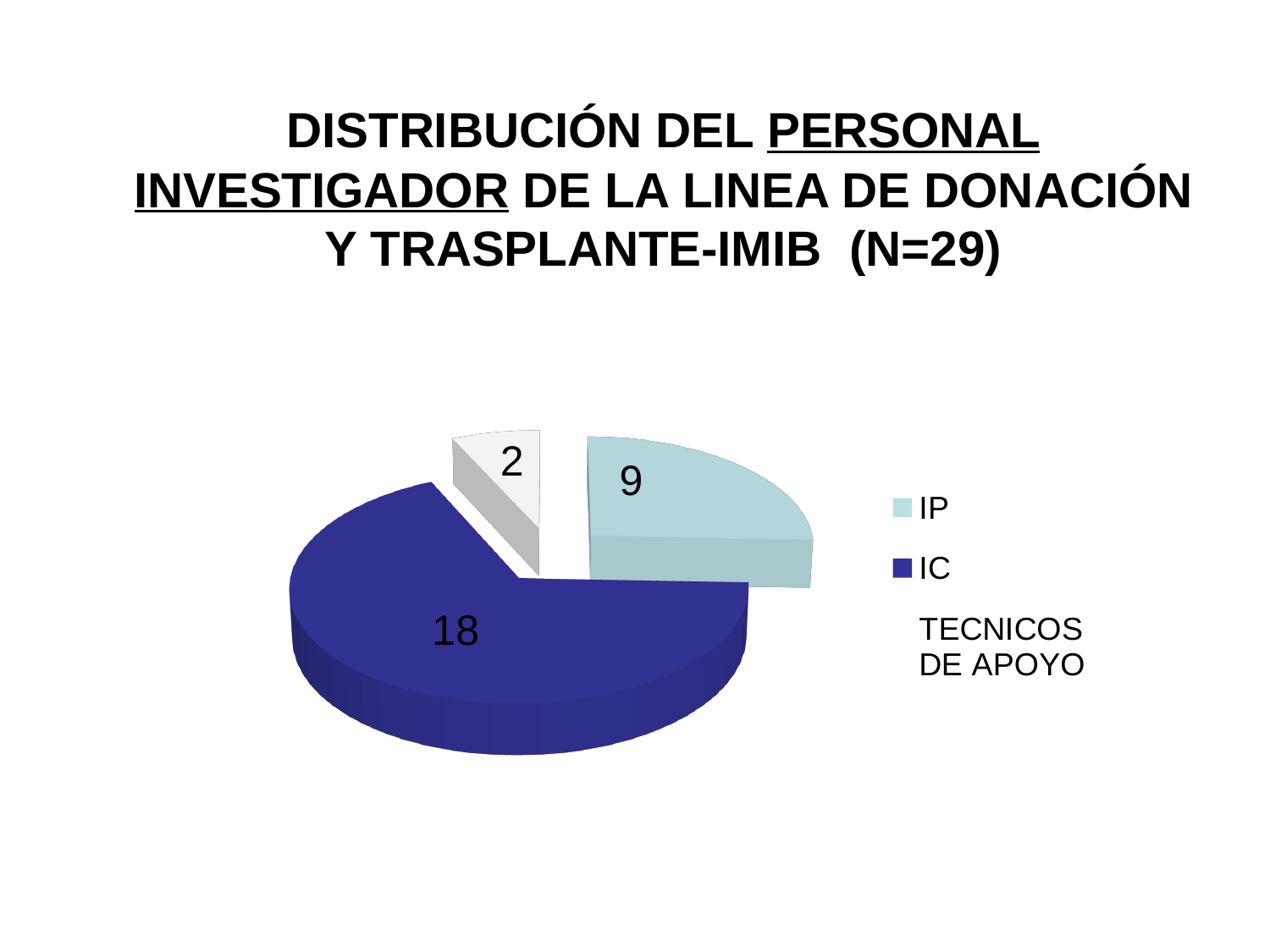
What is the total of all slices in the pie chart? 29 What colour is the IC slice in the pie chart? Dark blue Which category has the smallest slice of the pie chart? TECNICOS DE APOYO How many categories are shown in the pie chart? 3 Which is larger, the value for IP or the value for TECNICOS DE APOYO? IP What is the value for TECNICOS DE APOYO in the pie chart? 2 Which category has the largest slice of the pie chart? IC What is the value for IP in the pie chart? 9 What type of chart is shown on the slide? Pie chart What is the difference between the values for IP and TECNICOS DE APOYO? 7 What is the value for IC in the pie chart? 18 What is the difference between the values for IC and IP? 9